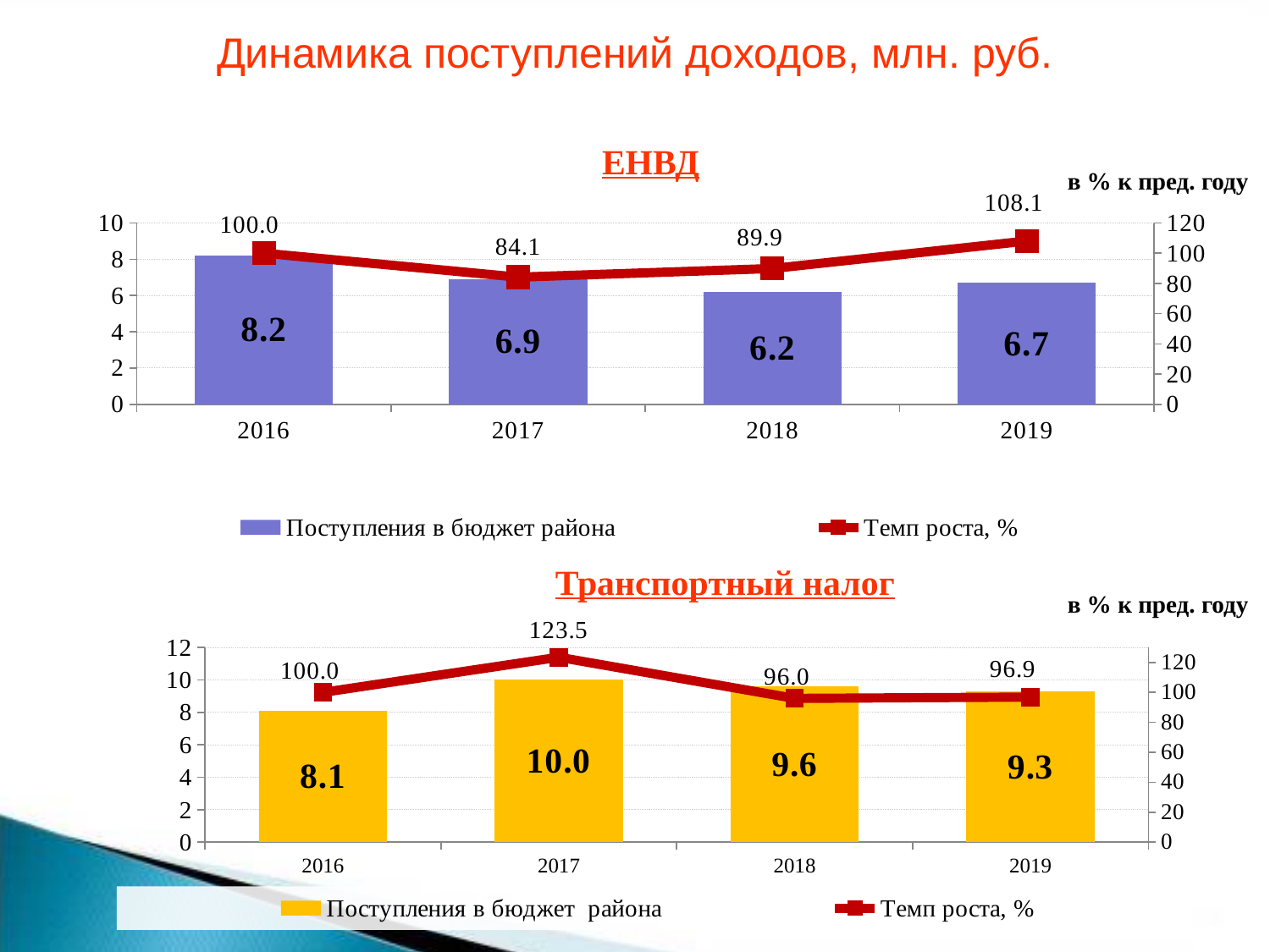
What colour are the bars in the Транспортный налог chart? Yellow In the Транспортный налог chart, is the Поступления в бюджет района value for 2018 larger or smaller than for 2019? larger In the Транспортный налог chart, what is the value of Поступления в бюджет района for 2019? 9.3 In the ЕНВД chart, what is the difference between the Поступления в бюджет района values for 2016 and 2018? 2.0 In the Транспортный налог chart, how many years are shown on the x axis? 4 In the ЕНВД chart, which year has the lowest Поступления в бюджет района? 2018 In the ЕНВД chart, what is the value of Поступления в бюджет района for 2017? 6.9 In the ЕНВД chart, how many series does the legend list? 2 In the ЕНВД chart, what is the Темп роста, % value for 2019? 108.1 In the Транспортный налог chart, which year has the highest Поступления в бюджет района? 2017 In the Транспортный налог chart, what is the Темп роста, % value for 2017? 123.5 In the Транспортный налог chart, what is the difference between the Темп роста, % values for 2017 and 2018? 27.5